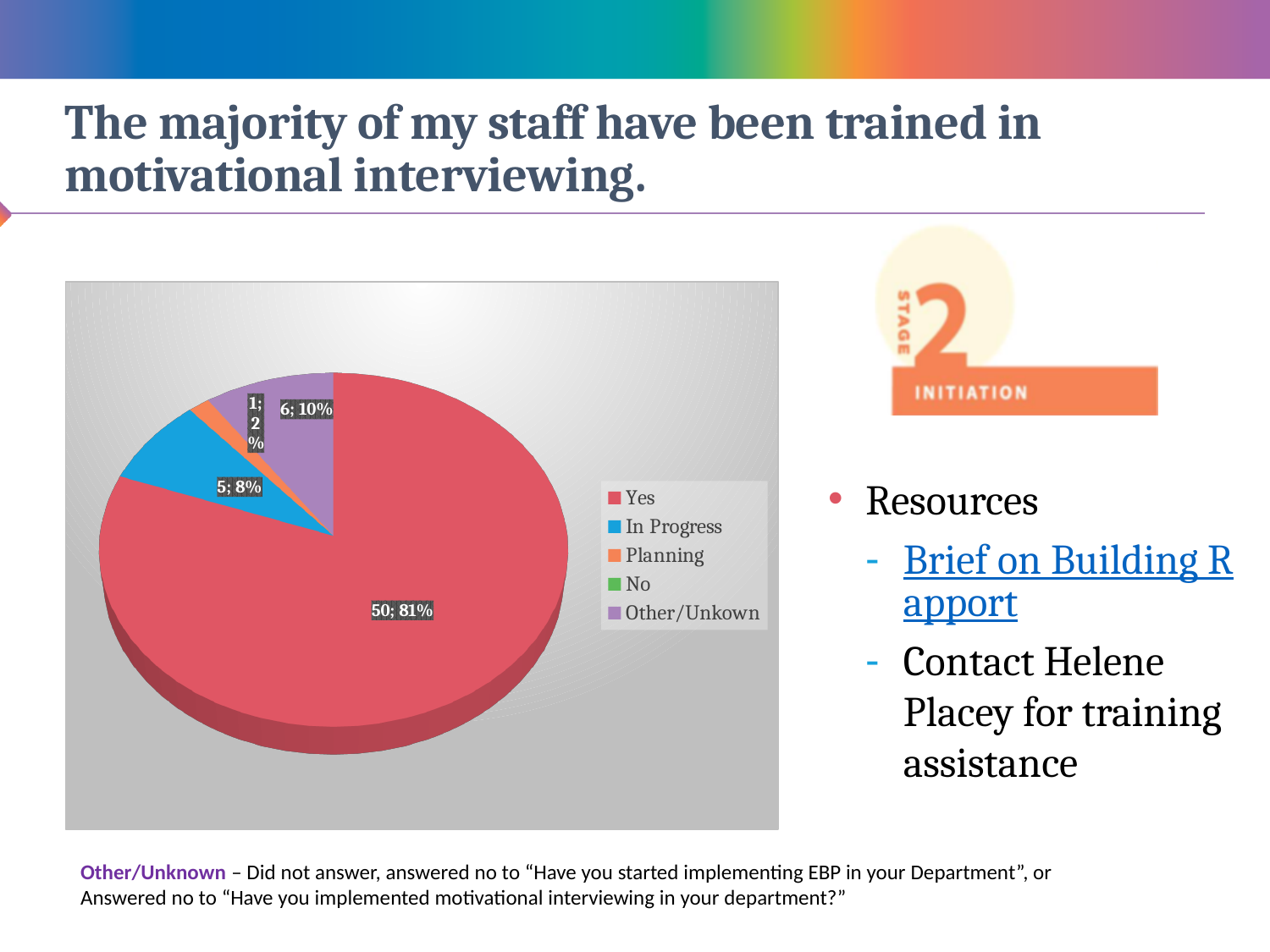
What is the count and percentage shown for the Planning slice? 1; 2% What is the difference in count between the Yes slice and the Other/Unknown slice? 44 What is the count and percentage shown for the In Progress slice? 5; 8% Which category has the largest slice of the pie? Yes What is the count and percentage shown for the Other/Unknown slice? 6; 10% What share of the pie does the Yes slice represent? 81% Which is larger, the In Progress slice or the Other/Unknown slice? Other/Unknown What is the difference in count between the In Progress slice and the Planning slice? 4 What kind of chart is shown on the slide? pie chart What is the count and percentage shown for the Yes slice? 50; 81% How many entries does the legend of the pie chart list? 5 What colour is the Yes slice in the pie chart? red